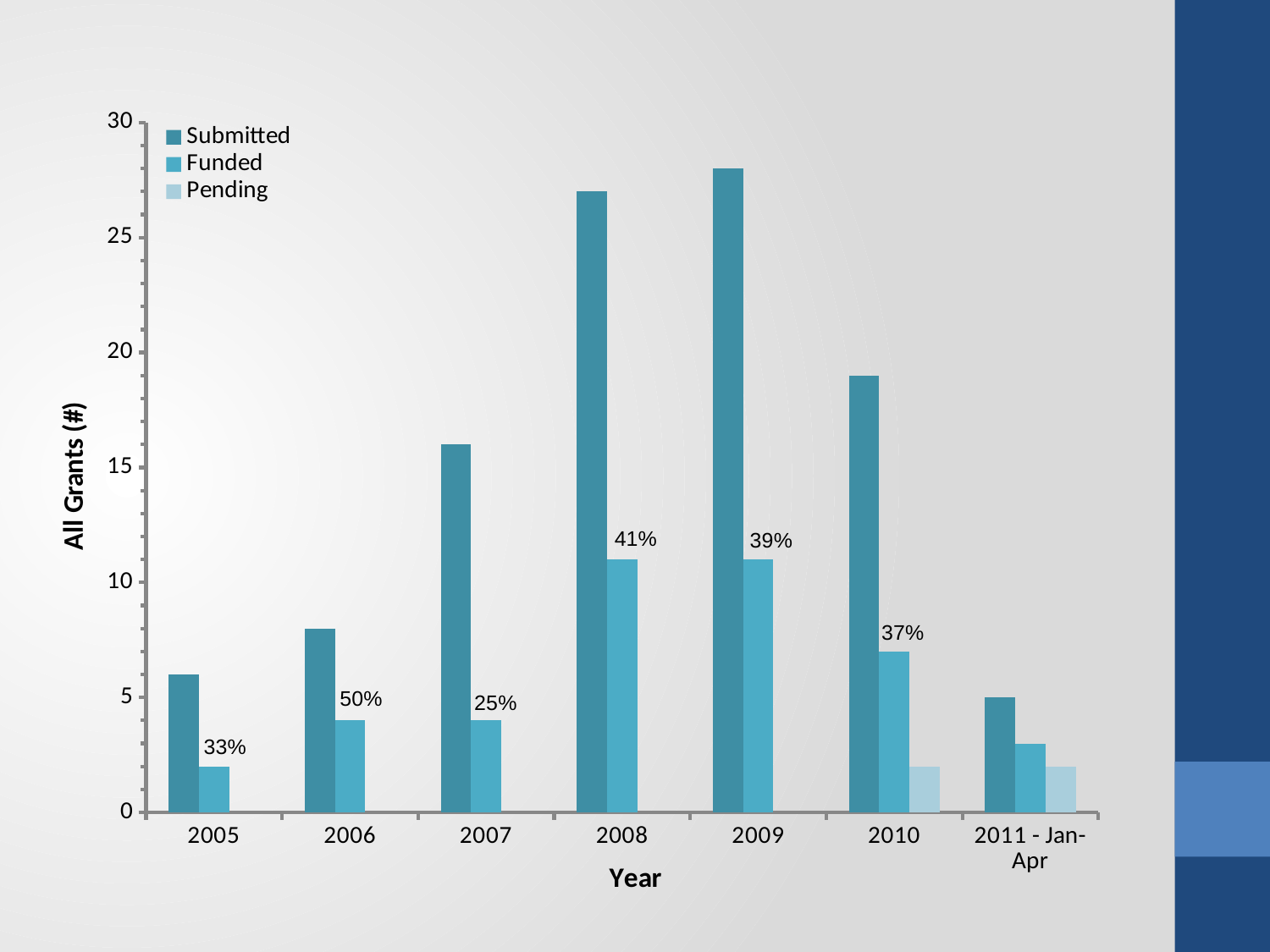
How many year categories are shown on the x axis? 7 What kind of chart is shown on the slide? bar chart What percentage label is shown on the Funded bar for 2006? 50% Is the Submitted value for 2009 greater or less than 25? greater Which year has the highest percentage label on its Funded bar? 2006 Which year has the larger Submitted value, 2006 or 2008? 2008 Is the Submitted value for 2010 greater or less than 20? less What is the title of the y axis? All Grants (#) What percentage label is shown on the Funded bar for 2008? 41% How many series does the legend list? 3 Which year has the lowest percentage label on its Funded bar? 2007 What percentage label is shown on the Funded bar for 2010? 37%